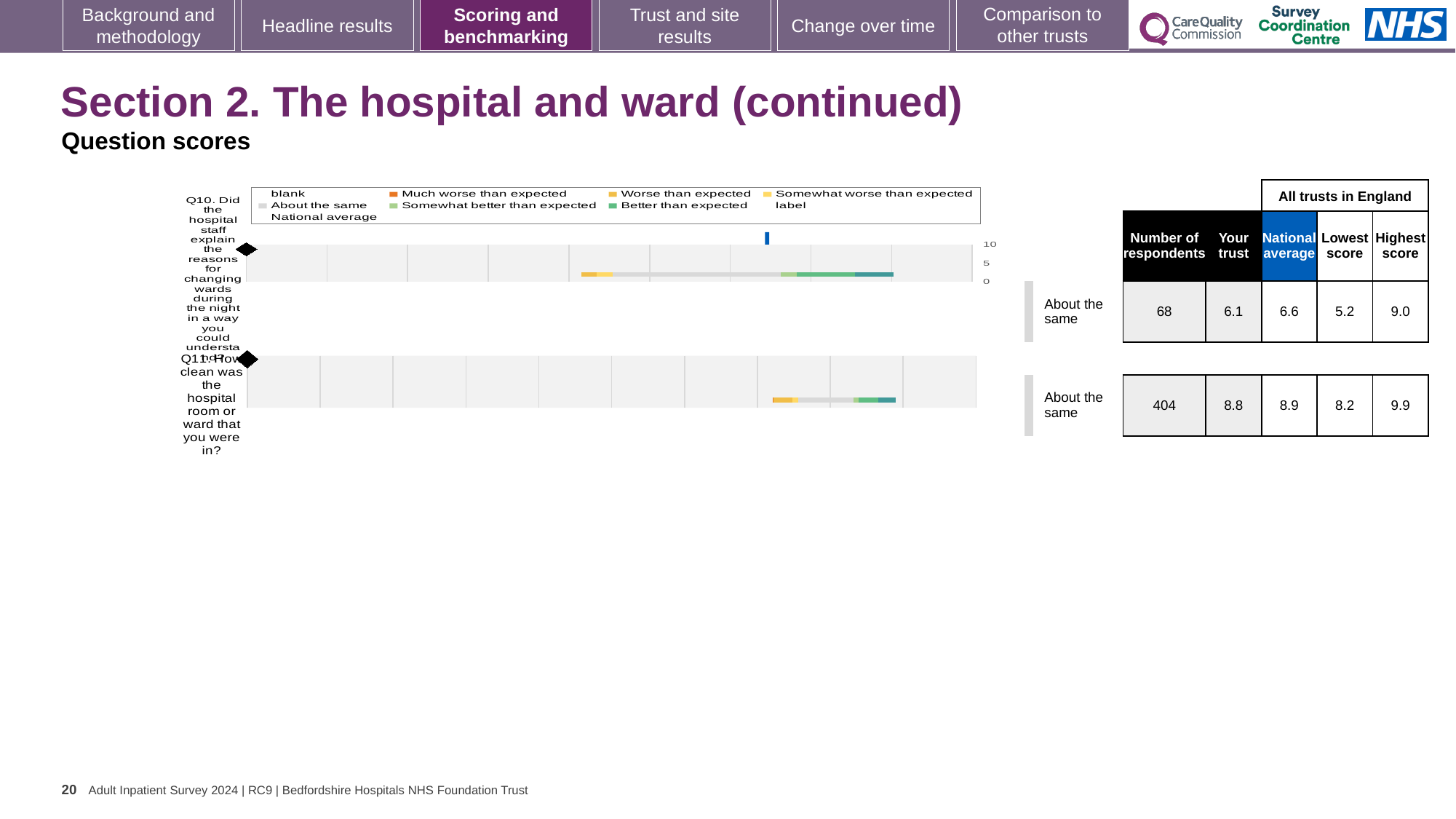
How many questions (Q10 and Q11) are charted on this slide? 2 For the Q11 chart, what is the highest score among all trusts in England? 9.9 What benchmark category is shown next to both the Q10 and Q11 charts? About the same For the Q10 chart, what is the difference between the highest score and the lowest score among all trusts in England? 3.8 Which question, Q10 or Q11, has the higher 'Your trust' score? Q11 For the Q10 chart (explaining reasons for changing wards during the night), how many respondents are shown? 68 For the Q11 chart, which is larger: the 'Your trust' score or the national average? National average For the Q11 chart (how clean was the hospital room or ward), what is the 'Your trust' score? 8.8 For the Q10 chart, what is the national average score? 6.6 For the Q10 chart, what is the 'Your trust' score? 6.1 How many entries does the legend above the charts list? 9 What kind of chart is used to show the question scores on this slide? bar chart